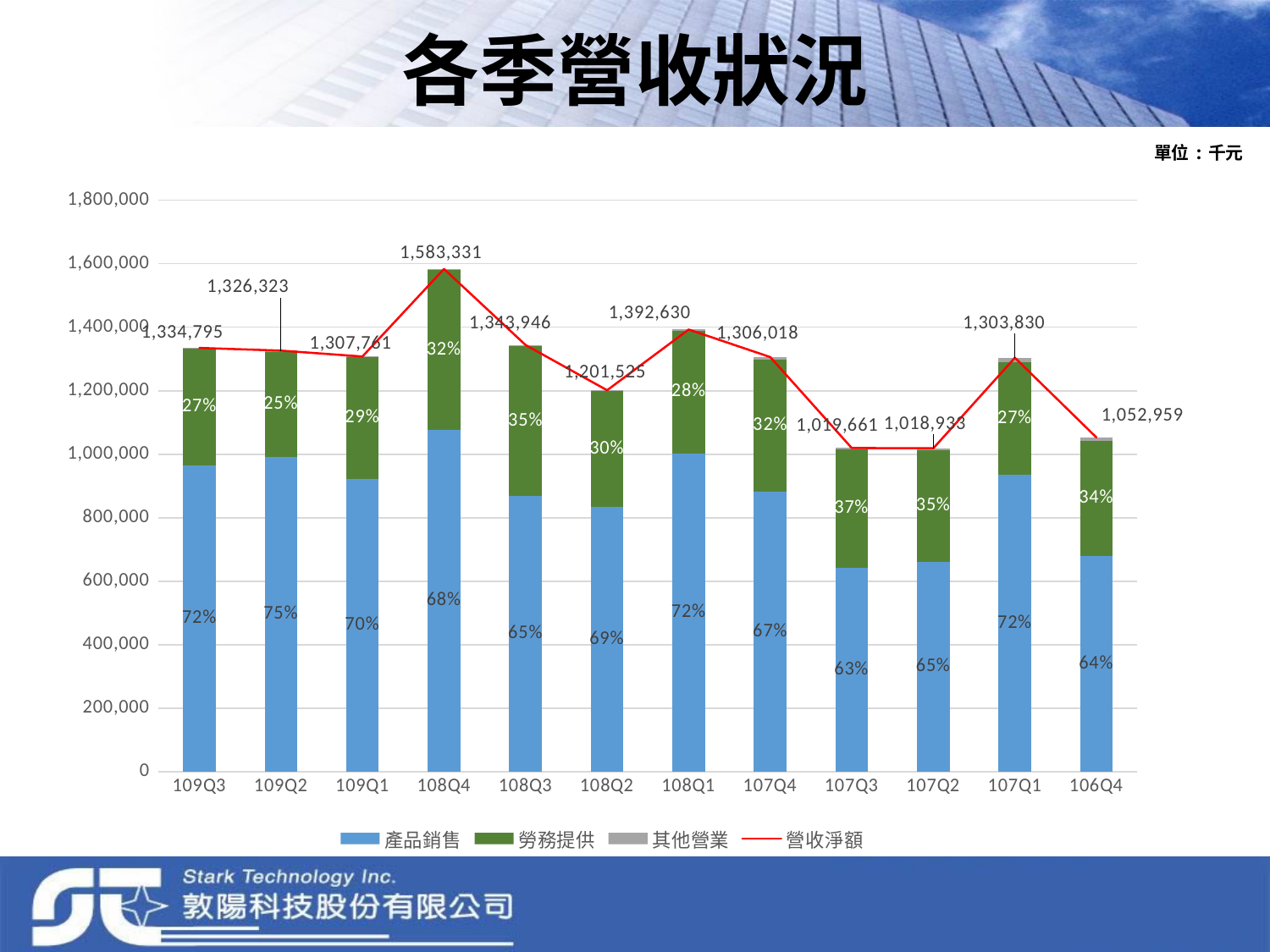
What percentage share does 勞務提供 have in 108Q3? 35% Which quarter has the highest 營收淨額? 108Q4 What is the 營收淨額 value for 109Q2? 1,326,323 What percentage share does 產品銷售 have in 107Q3? 63% What is the 營收淨額 value for 108Q4? 1,583,331 Is the 產品銷售 value for 108Q4 greater or less than 1,000,000? greater How many series does the legend list? 4 What unit is stated for the chart values? 千元 Which quarter has the lowest 產品銷售 percentage share? 107Q3 What is the difference in 營收淨額 between 108Q4 and 109Q3? 248,536 How many quarters are shown on the x axis? 12 Which quarter has a larger 營收淨額, 108Q1 or 107Q4? 108Q1